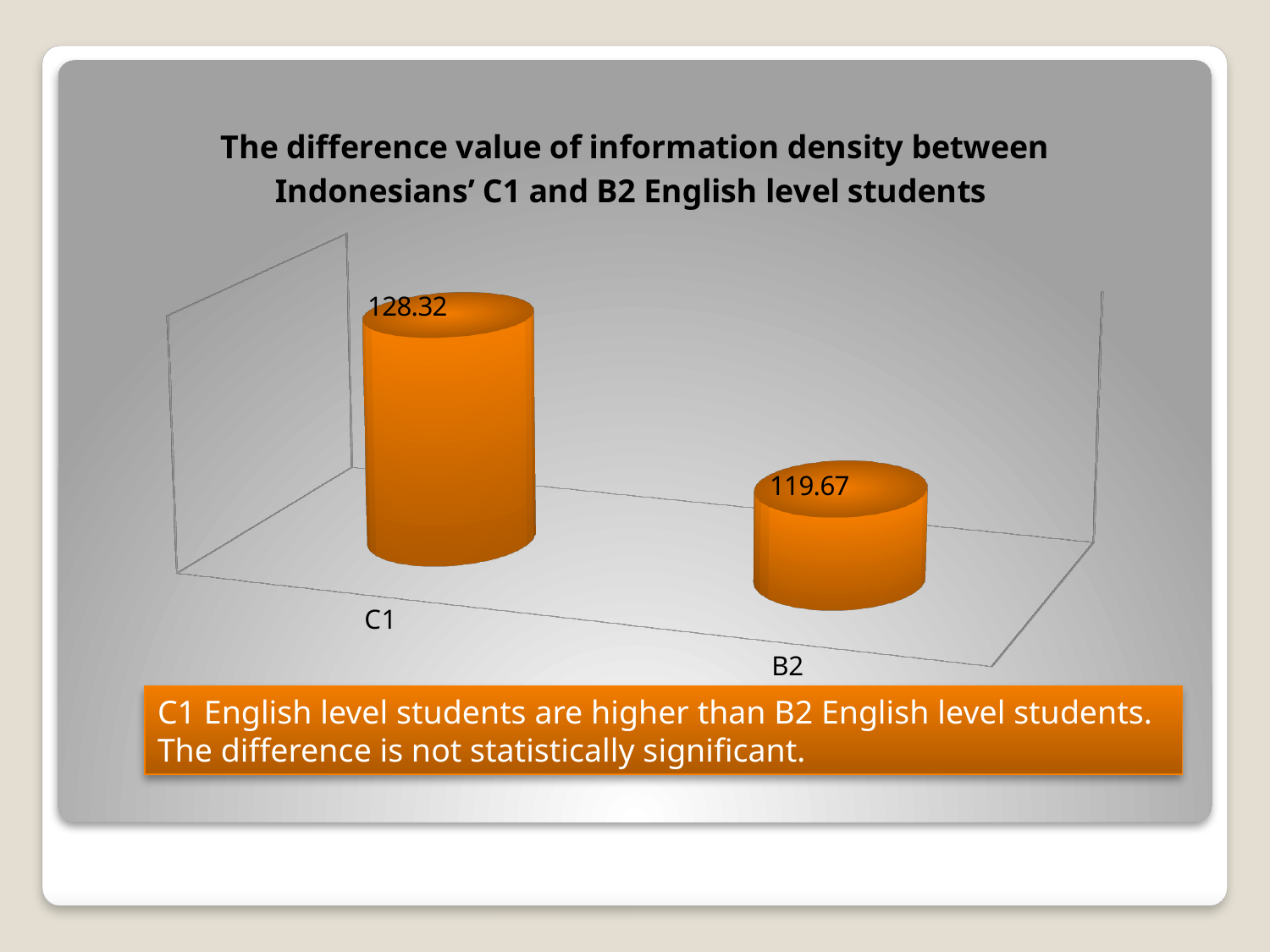
What is the information density value for B2? 119.67 How many categories are plotted in the chart? 2 What is the information density value for C1? 128.32 Do the values rise or fall from C1 to B2 along the x axis? fall What is the title of the chart? The difference value of information density between Indonesians' C1 and B2 English level students What is the difference between the C1 and B2 information density values? 8.65 Which English level has the higher information density value? C1 What colour are the bars in the chart? orange Which English level has the lower information density value? B2 What kind of chart is shown on the slide? bar chart Is the value for C1 larger or smaller than the value for B2? larger